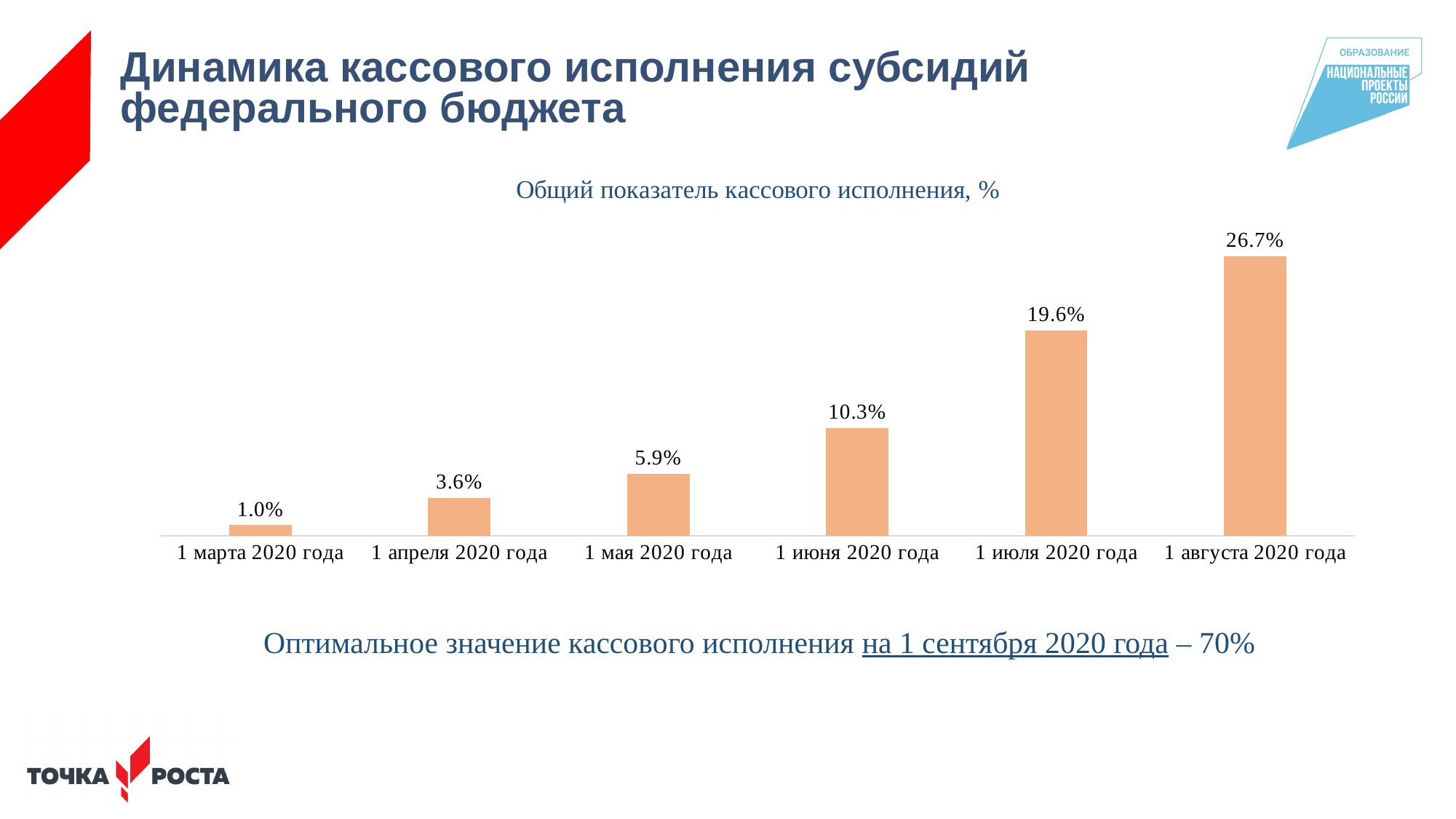
What is the difference between the values for 1 августа 2020 года and 1 июля 2020 года? 7.1% What is the value for 1 марта 2020 года? 1.0% Which is larger, the value for 1 июня 2020 года or 1 мая 2020 года? 1 июня 2020 года What is the value for 1 июня 2020 года? 10.3% What is the difference between the values for 1 мая 2020 года and 1 апреля 2020 года? 2.3% What kind of chart is this? bar chart Do the values rise or fall from 1 марта 2020 года to 1 августа 2020 года? rise What is the title of the chart? Общий показатель кассового исполнения, % Which date has the lowest value? 1 марта 2020 года How many dates are shown on the x axis? 6 Which date has the highest value? 1 августа 2020 года What is the value for 1 августа 2020 года? 26.7%